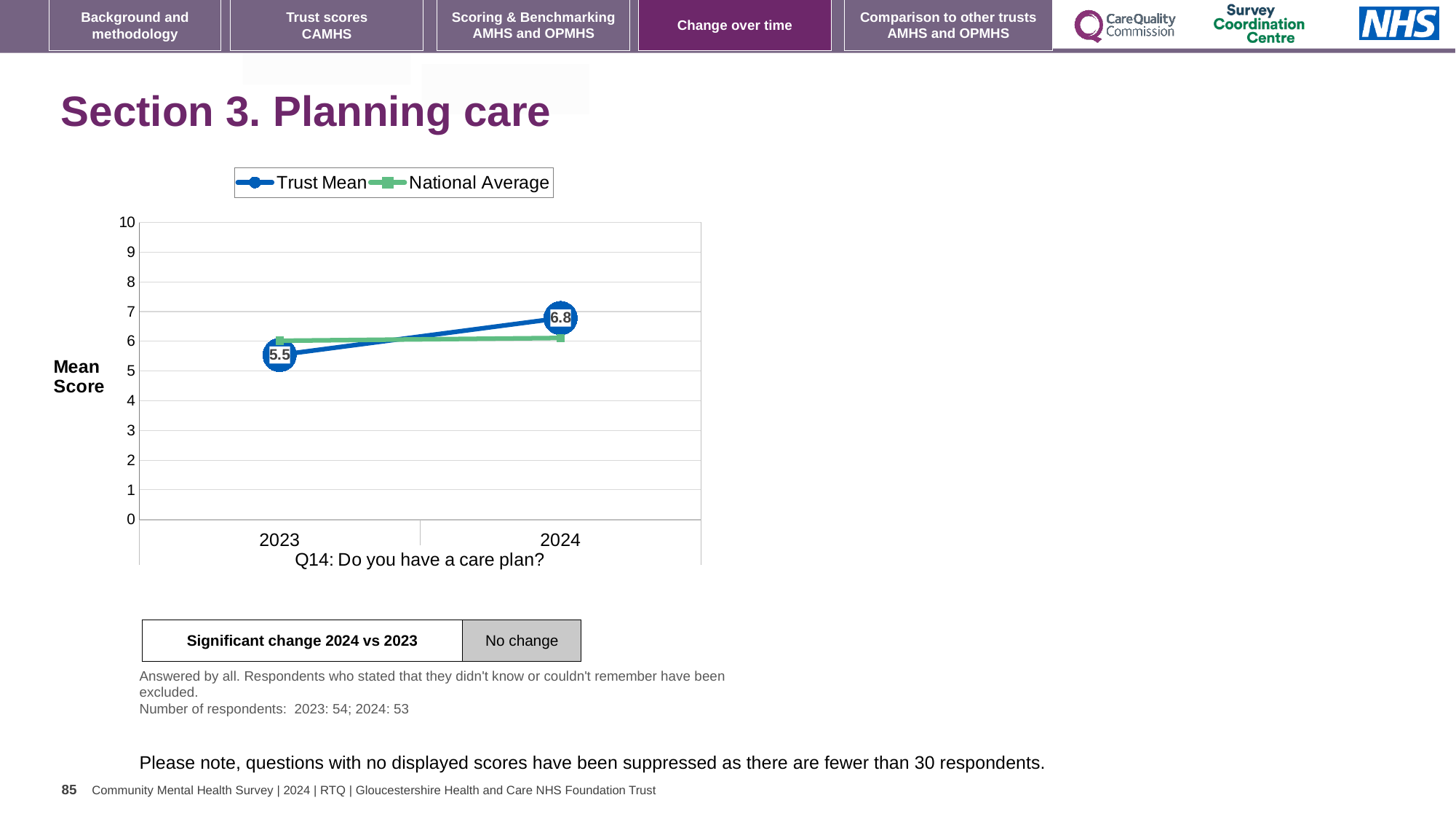
In which year is the Trust Mean score lowest? 2023 What is the difference between the Trust Mean scores for 2024 and 2023? 1.3 Is the National Average value for 2023 greater or less than 5? greater In which year is the Trust Mean score highest? 2024 Is the National Average value for 2024 greater or less than 7? less What kind of chart is shown on the slide? Line chart In 2023, which is larger: the Trust Mean or the National Average? National Average How many series does the legend list? 2 What is the Trust Mean score for 2023? 5.5 In 2024, which is larger: the Trust Mean or the National Average? Trust Mean What is the Trust Mean score for 2024? 6.8 Does the Trust Mean rise or fall from 2023 to 2024? Rise